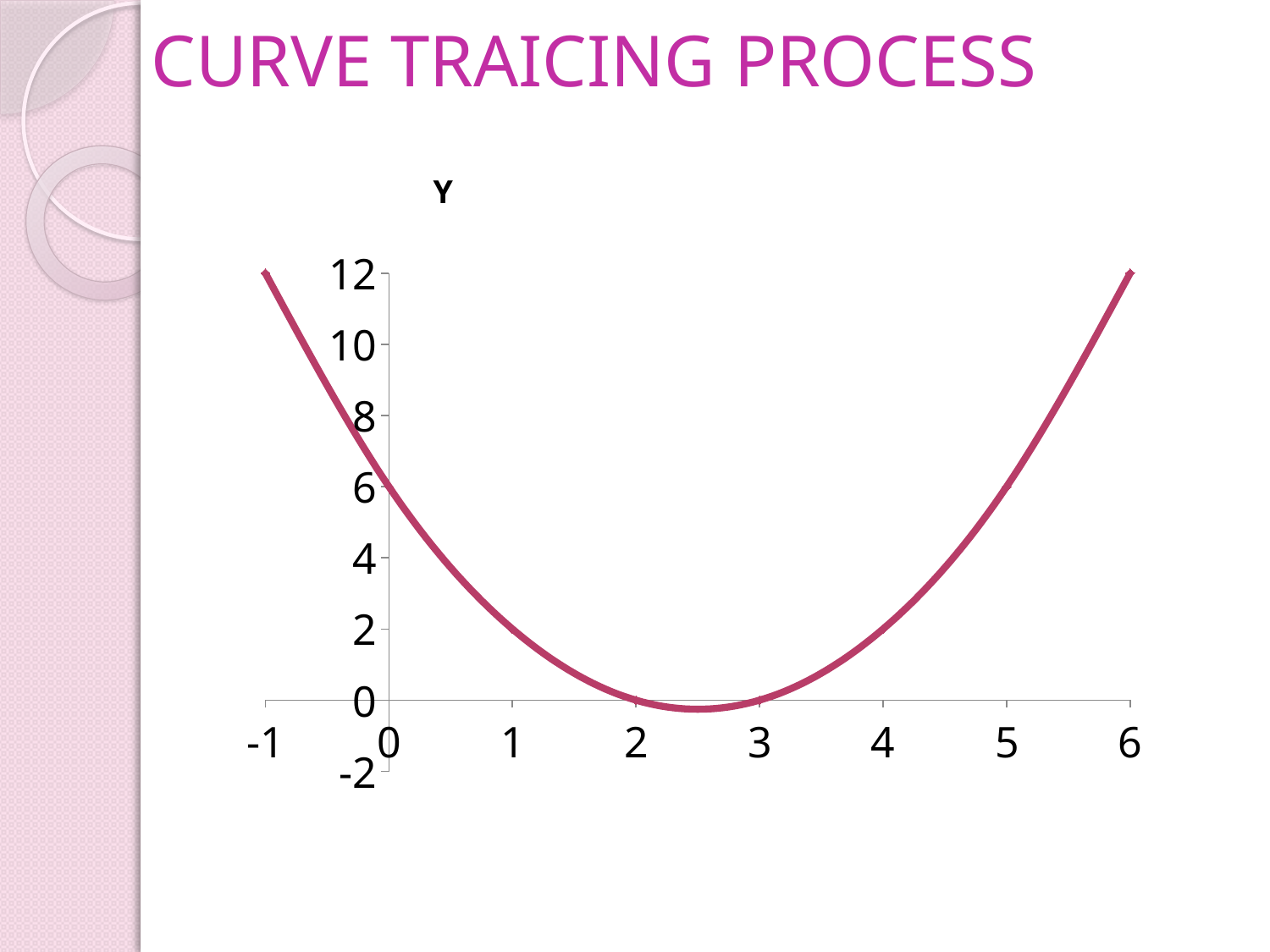
What is the value of the curve at x = 0? 6 Is the value of the curve at x = 5 greater or less than 4? greater Which is larger, the value of the curve at x = -1 or at x = 1? x = -1 At which x values does the curve cross the x axis (y = 0)? 2 and 3 What is the value of the curve at x = -1? 12 Does the curve rise or fall as x goes from 3 to 6? rise What is the highest value shown on the y axis? 12 What is the label on the vertical axis of the chart? Y Is the value of the curve at x = 1 greater or less than 4? less What kind of chart is shown on the slide? line chart Does the curve rise or fall as x goes from -1 to 2? fall What is the value of the curve at x = 6? 12